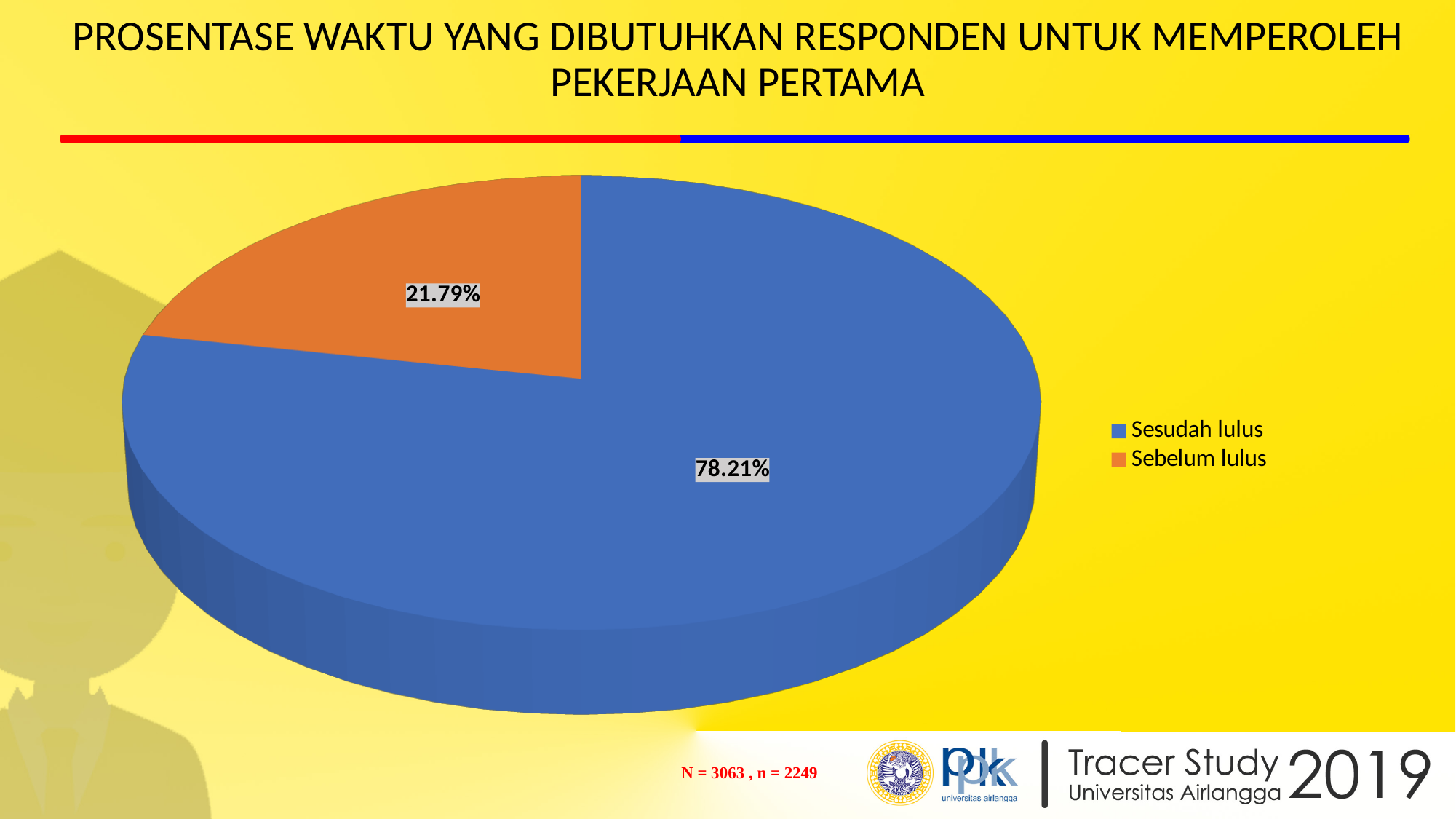
How many categories does the pie chart show? 2 What colour is the Sesudah lulus slice? Blue Which is larger, the share for Sesudah lulus or the share for Sebelum lulus? Sesudah lulus Which category has the smallest share of the pie? Sebelum lulus What is the difference in percentage points between Sesudah lulus and Sebelum lulus? 56.42% Which category has the largest share of the pie? Sesudah lulus How many entries does the legend list? 2 What share of the pie does the Sebelum lulus slice represent? 21.79% What kind of chart is shown on the slide? Pie chart What percentage of respondents obtained their first job before graduating (Sebelum lulus)? 21.79% What percentage of respondents obtained their first job after graduating (Sesudah lulus)? 78.21% What colour is the Sebelum lulus slice? Orange